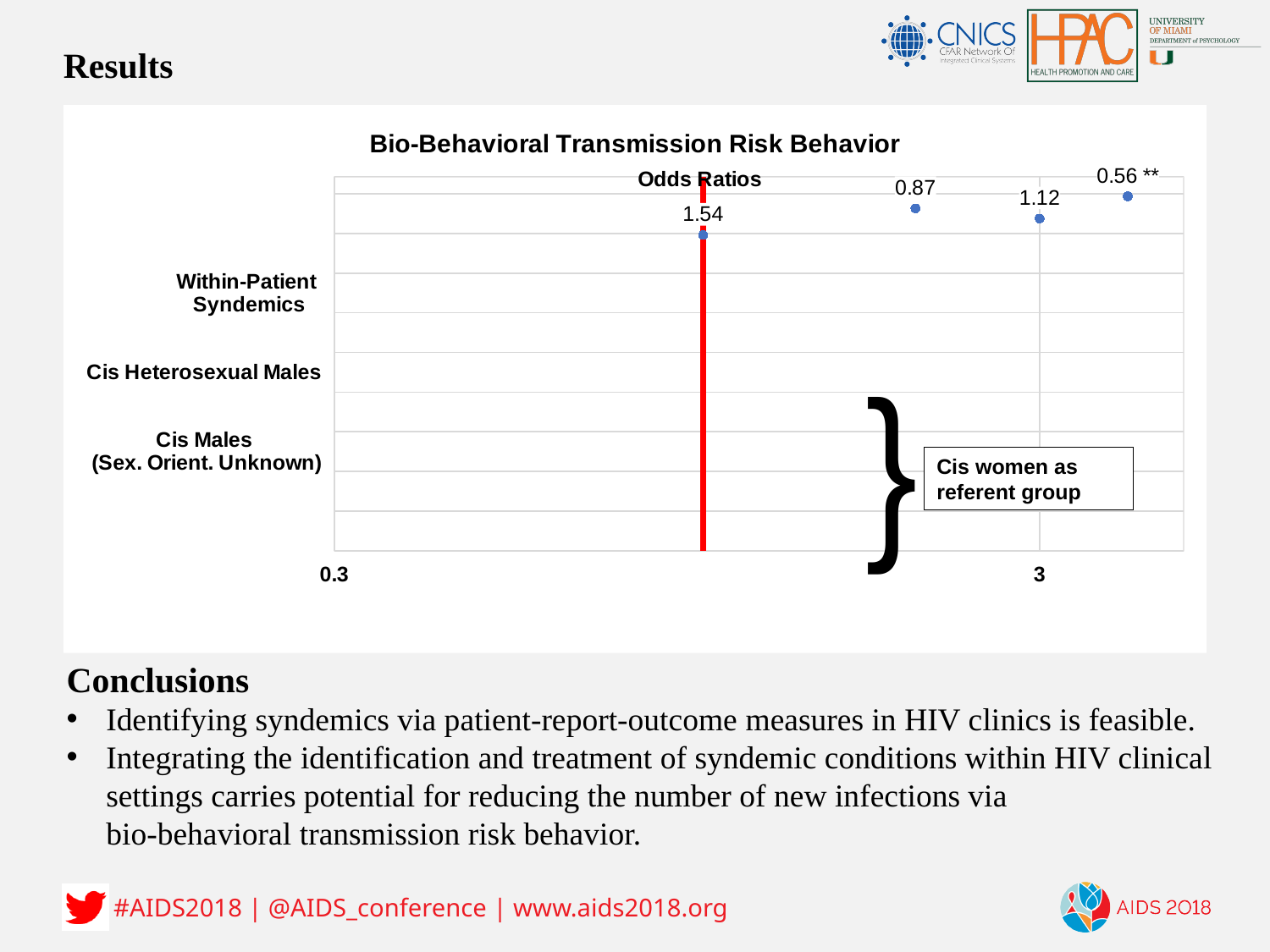
What is the largest odds ratio labeled on the chart? 1.54 What kind of chart is shown on the slide? Scatter (dot) plot What are the two tick values shown on the x axis? 0.3 and 3 How many data points are plotted on the chart? 4 How many category labels are listed on the y axis of the chart? 3 What is the difference between the largest labeled odds ratio (1.54) and the smallest labeled odds ratio (0.56)? 0.98 Which odds ratio label on the chart is marked with two asterisks? 0.56 What is the title of the chart? Bio-Behavioral Transmission Risk Behavior What is the difference between the odds ratios labeled 1.12 and 0.87? 0.25 Which labeled odds ratio is larger, 0.87 or 1.12? 1.12 What is the smallest odds ratio labeled on the chart? 0.56